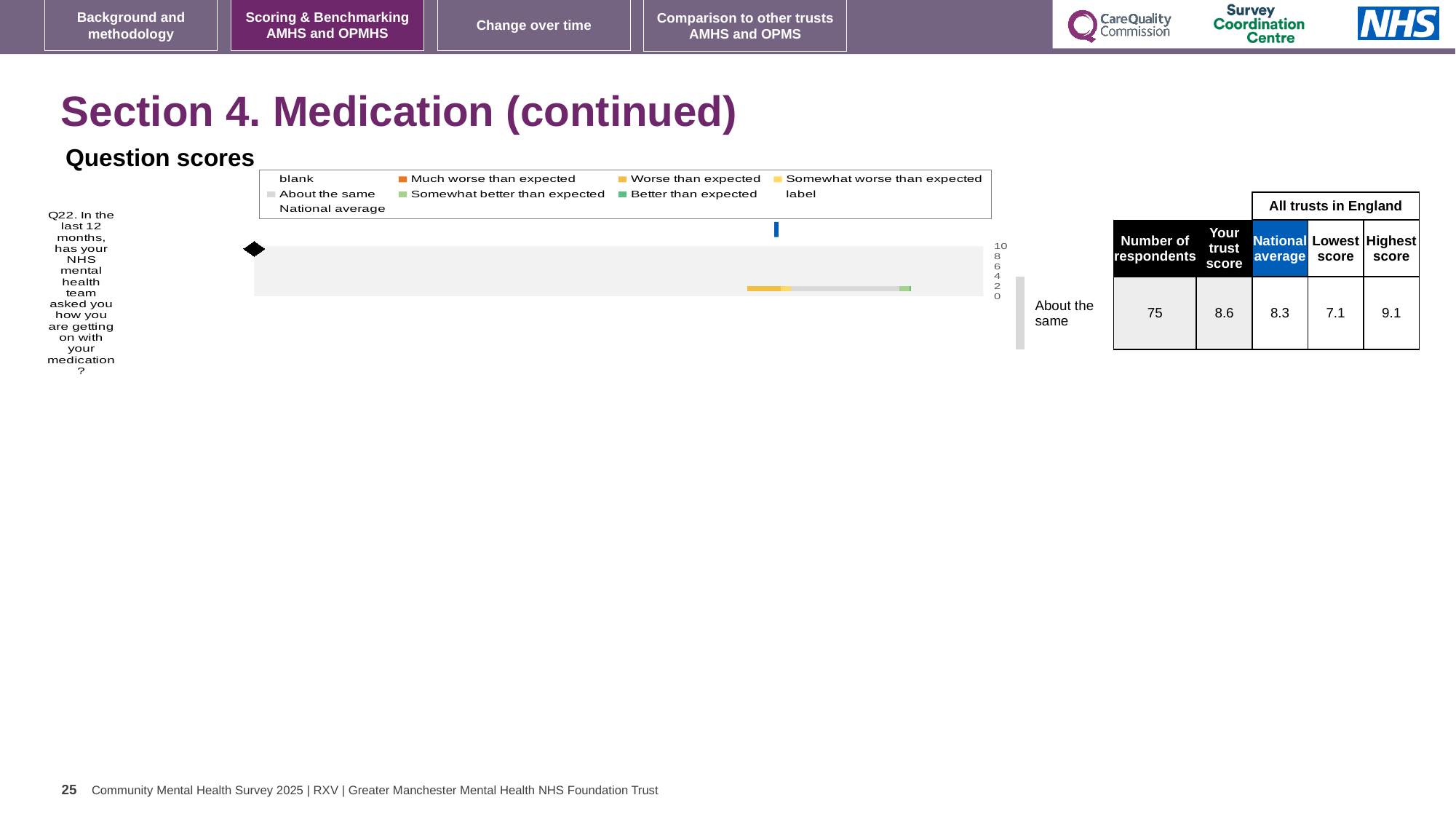
In the table beside the chart, what is the highest score among all trusts in England for Q22? 9.1 For Q22, what is the difference between the highest score and the lowest score among all trusts in England? 2.0 What is the highest tick value shown on the chart's score axis? 10 For Q22, which is larger: your trust score or the national average? Your trust score What kind of chart is shown under 'Question scores'? bar chart How many survey questions are plotted in the chart? 1 Which benchmark category is Q22 assigned to, according to the label beside the chart? About the same In the table beside the chart, what is the lowest score among all trusts in England for Q22? 7.1 In the table beside the chart, what is the number of respondents for Q22? 75 In the table beside the chart, what is 'Your trust score' for Q22? 8.6 In the table beside the chart, what is the national average for Q22? 8.3 Which question is plotted in the chart? Q22